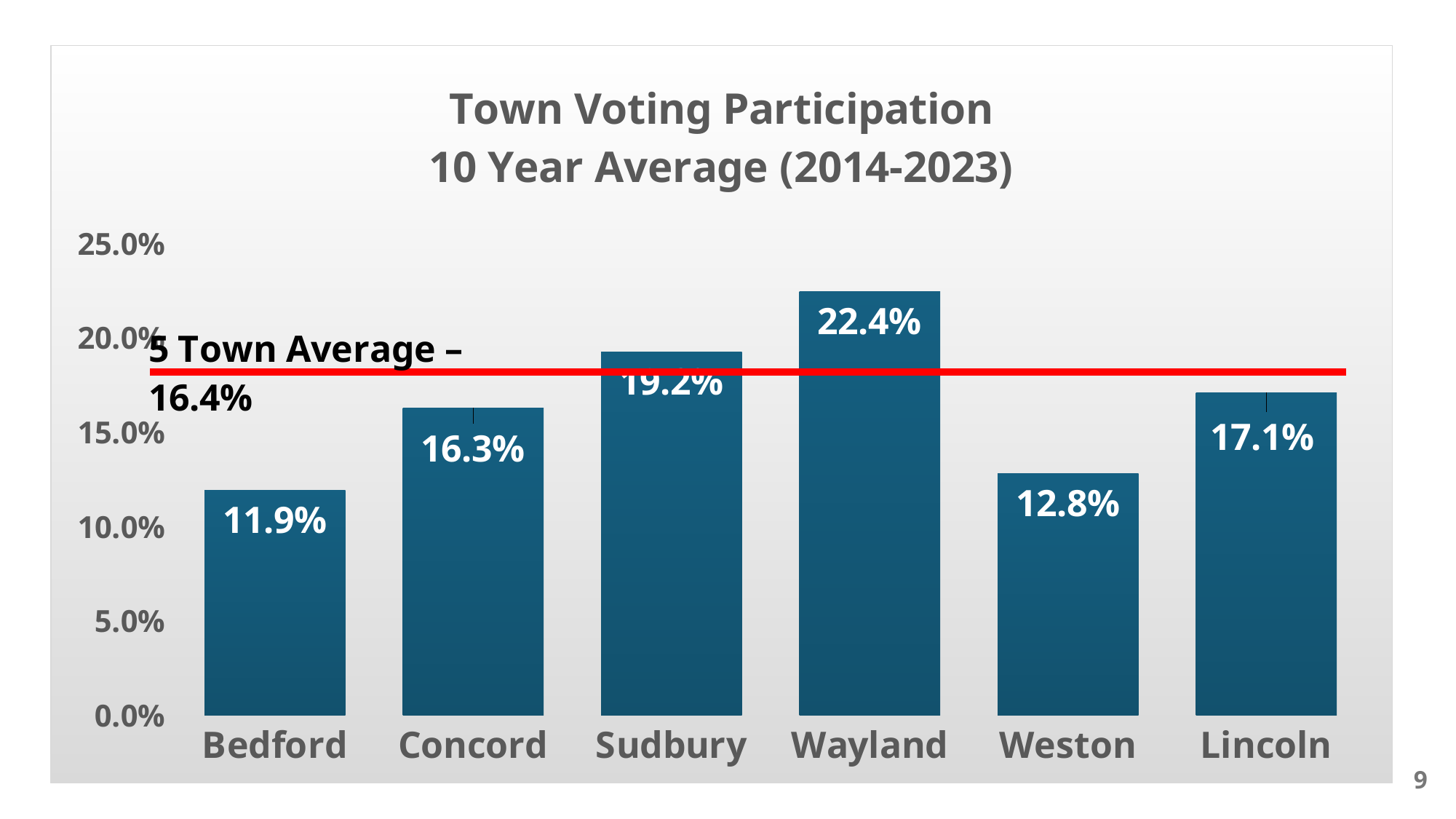
What is the voting participation value shown for Wayland? 22.4% What is the voting participation value shown for Lincoln? 17.1% What type of chart is shown on the slide? Bar chart Which town has the lowest voting participation? Bedford Which town has the highest voting participation? Wayland What is the voting participation value shown for Weston? 12.8% Which has higher voting participation, Sudbury or Weston? Sudbury What value does the red horizontal line labelled '5 Town Average' represent? 16.4% What is the difference in voting participation between Lincoln and Concord? 0.8% What is the 10-year average voting participation for Bedford? 11.9% How many towns are shown in the chart? 6 What is the difference in voting participation between Wayland and Bedford? 10.5%